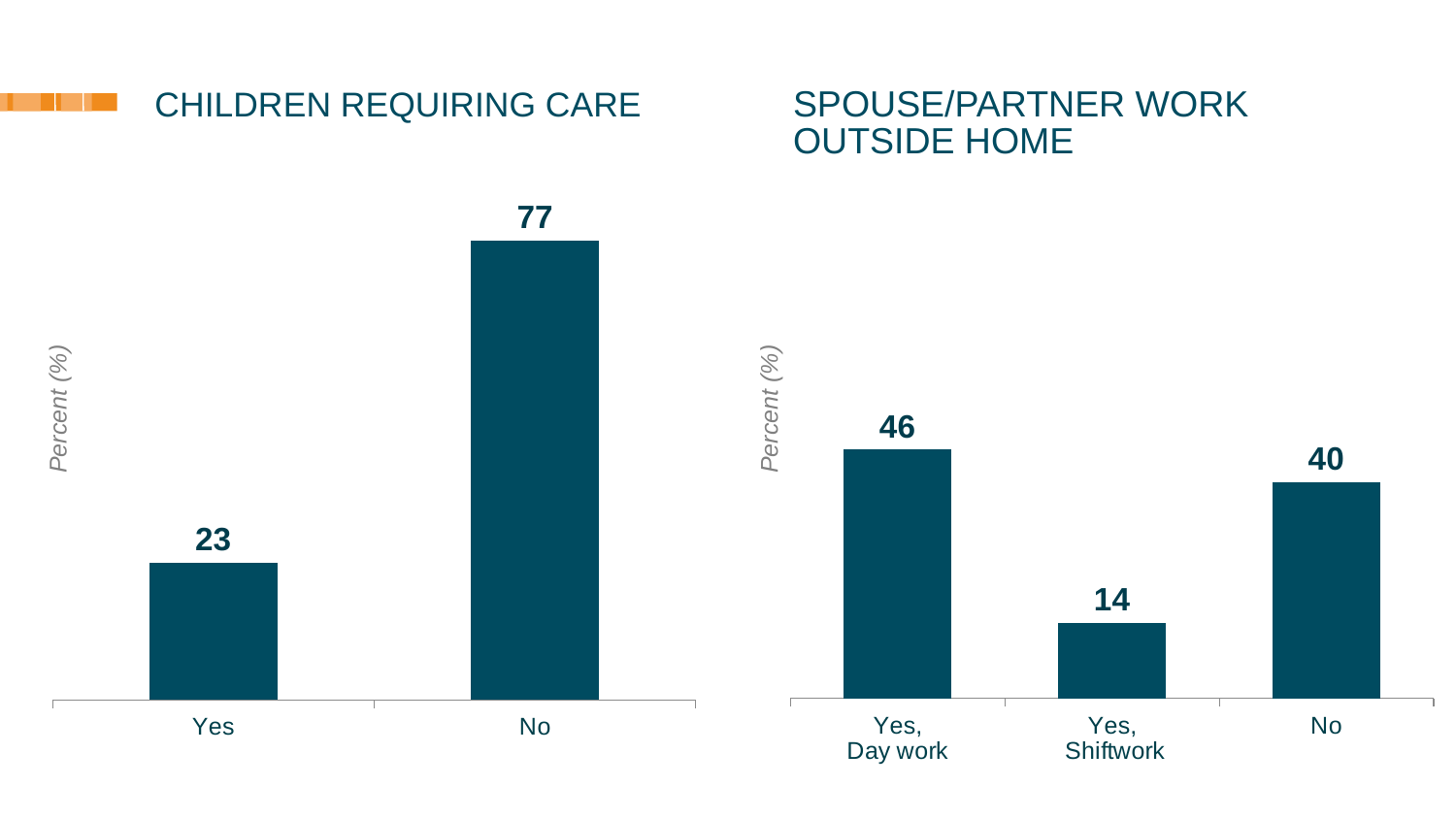
In the 'Children Requiring Care' chart, what is the value for 'No'? 77 In the 'Children Requiring Care' chart, what is the difference between the values for 'No' and 'Yes'? 54 In the 'Children Requiring Care' chart, which category has the highest value? No In the 'Spouse/Partner Work Outside Home' chart, which category has the lowest value? Yes, Shiftwork In the 'Children Requiring Care' chart, what is the value for 'Yes'? 23 In the 'Spouse/Partner Work Outside Home' chart, what is the difference between 'Yes, Day work' and 'Yes, Shiftwork'? 32 In the 'Spouse/Partner Work Outside Home' chart, what is the value for 'Yes, Shiftwork'? 14 In the 'Spouse/Partner Work Outside Home' chart, what is the value for 'No'? 40 In the 'Spouse/Partner Work Outside Home' chart, which is larger: 'Yes, Day work' or 'No'? Yes, Day work How many categories are shown in the 'Spouse/Partner Work Outside Home' chart? 3 In the 'Spouse/Partner Work Outside Home' chart, what is the value for 'Yes, Day work'? 46 What type of chart is the 'Children Requiring Care' chart? Bar chart